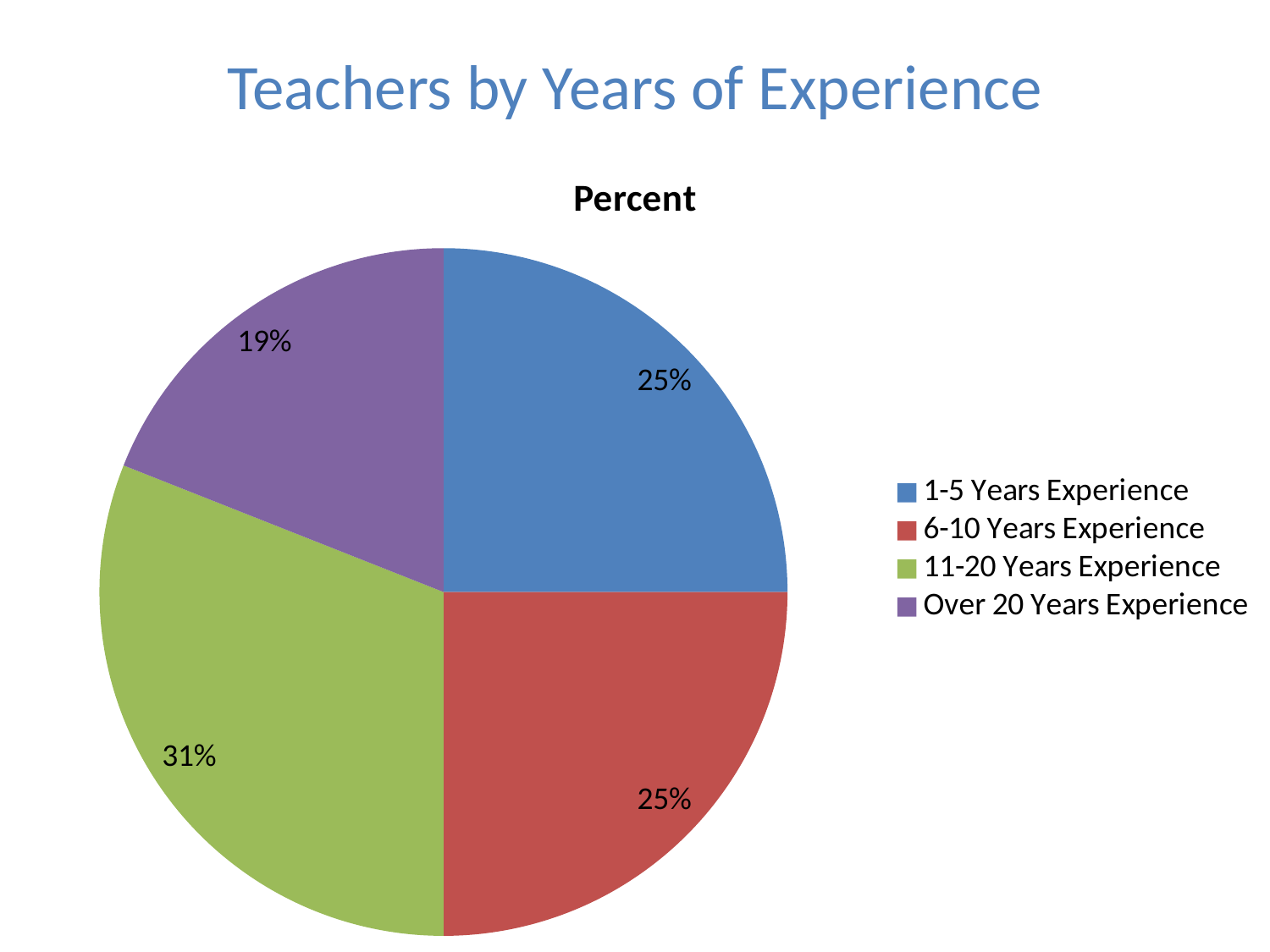
What percentage of teachers have 1-5 years of experience? 25% Which experience category has the smallest share of teachers? Over 20 Years Experience Which is larger: the share for 11-20 Years Experience or the share for 1-5 Years Experience? 11-20 Years Experience What kind of chart is shown on the slide? pie chart Which experience category has the largest share of teachers? 11-20 Years Experience What is the title of the chart? Percent What percentage of teachers have over 20 years of experience? 19% What percentage of teachers have 6-10 years of experience? 25% What colour is the slice for Over 20 Years Experience? purple What is the difference in percentage points between the 11-20 Years Experience slice and the Over 20 Years Experience slice? 12 What percentage of teachers have 11-20 years of experience? 31% How many slices does the pie chart have? 4